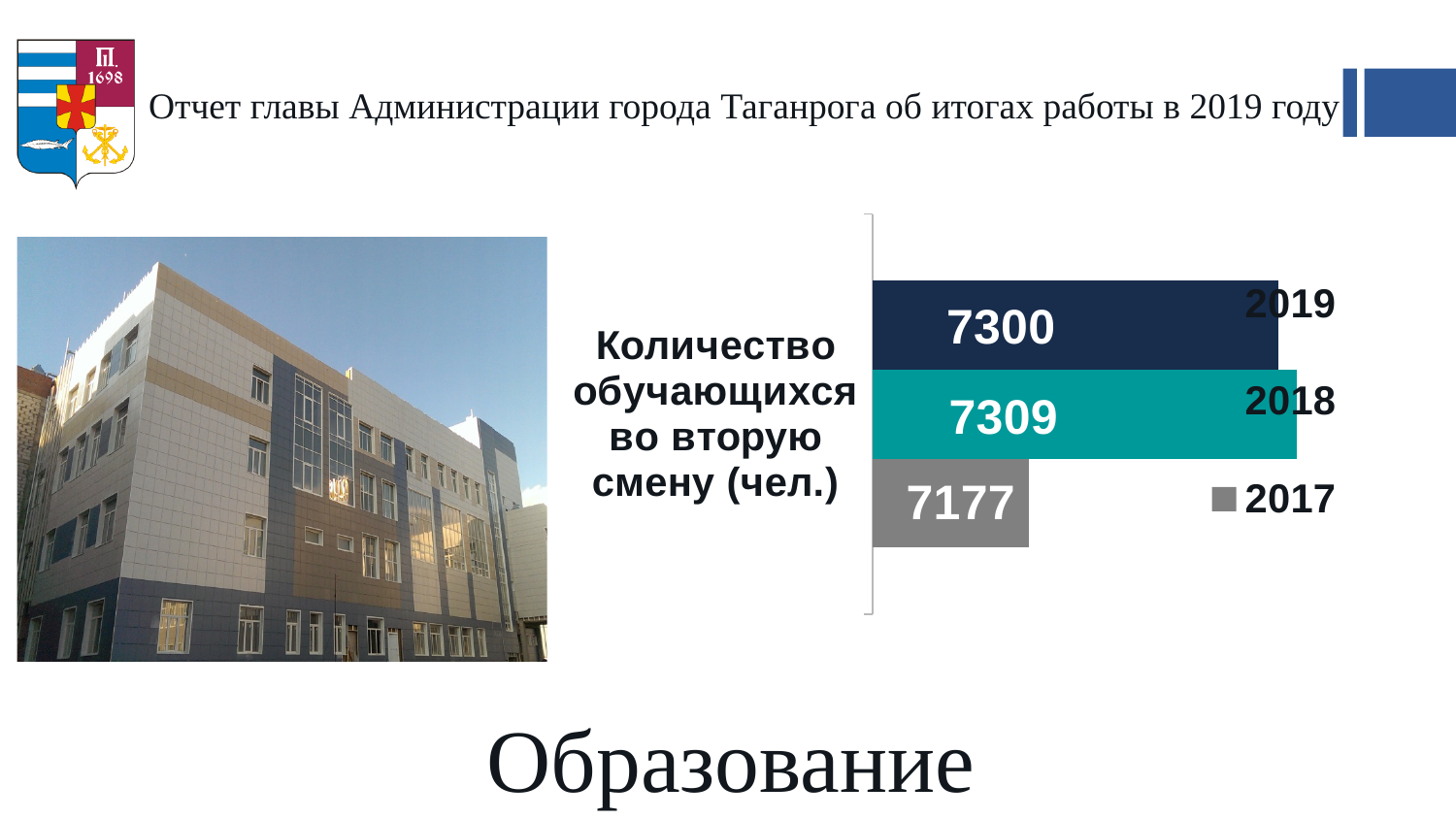
Which year has the highest number of students in the second shift? 2018 What is the number of students studying in the second shift in 2019? 7300 What is the number of students studying in the second shift in 2018? 7309 How many years (bars) are shown in the chart? 3 How many entries does the chart legend list? 3 Which is larger: the number of second-shift students in 2018 or in 2017? 2018 What is the difference between the 2019 and 2017 values for students in the second shift? 123 What type of chart is used to show the number of students in the second shift? Bar chart What is the title of the chart on the slide? Количество обучающихся во вторую смену (чел.) What is the number of students studying in the second shift in 2017? 7177 What is the difference between the 2018 and 2019 values for students in the second shift? 9 Which year has the lowest number of students in the second shift? 2017